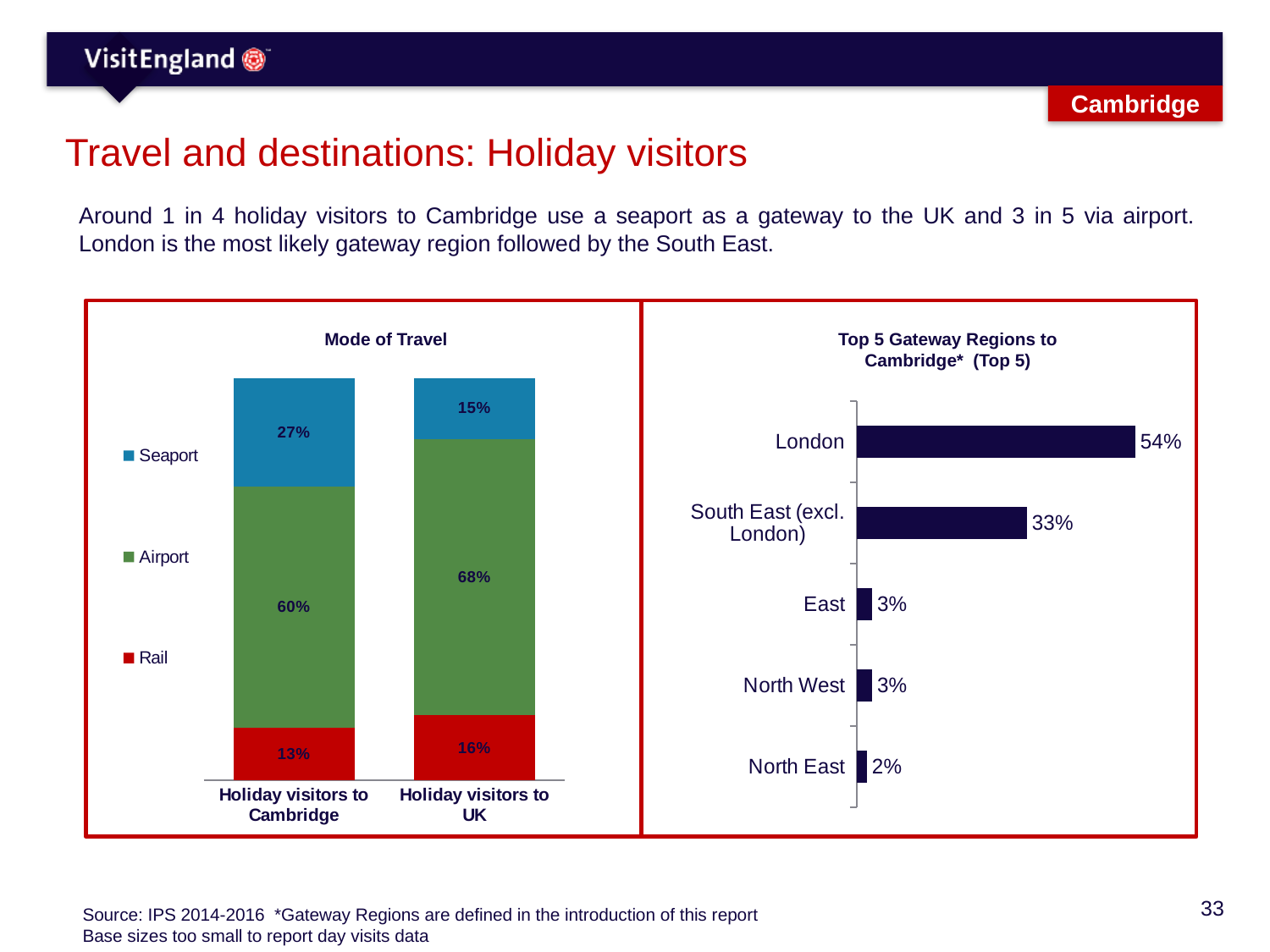
In the Top 5 Gateway Regions to Cambridge chart, which region has the highest value? London In the Mode of Travel chart, how many series does the legend list? 3 In the Mode of Travel chart, which is larger: the Seaport share for holiday visitors to Cambridge or for holiday visitors to the UK? Holiday visitors to Cambridge What kind of chart is the Top 5 Gateway Regions to Cambridge chart? Bar chart In the Mode of Travel chart, what percentage of holiday visitors to the UK travel by Airport? 68% In the Mode of Travel chart, what is the Rail share for holiday visitors to Cambridge? 13% In the Top 5 Gateway Regions to Cambridge chart, what is the difference between London and South East (excl. London)? 21% In the Mode of Travel chart, what is the difference between the Airport share for holiday visitors to the UK and for holiday visitors to Cambridge? 8% In the Top 5 Gateway Regions to Cambridge chart, what is the value for South East (excl. London)? 33% In the Top 5 Gateway Regions to Cambridge chart, which region has the lowest value? North East In the Mode of Travel chart, what percentage of holiday visitors to Cambridge travel by Seaport? 27% In the Mode of Travel chart, what is the total of the stacked bar for holiday visitors to Cambridge? 100%